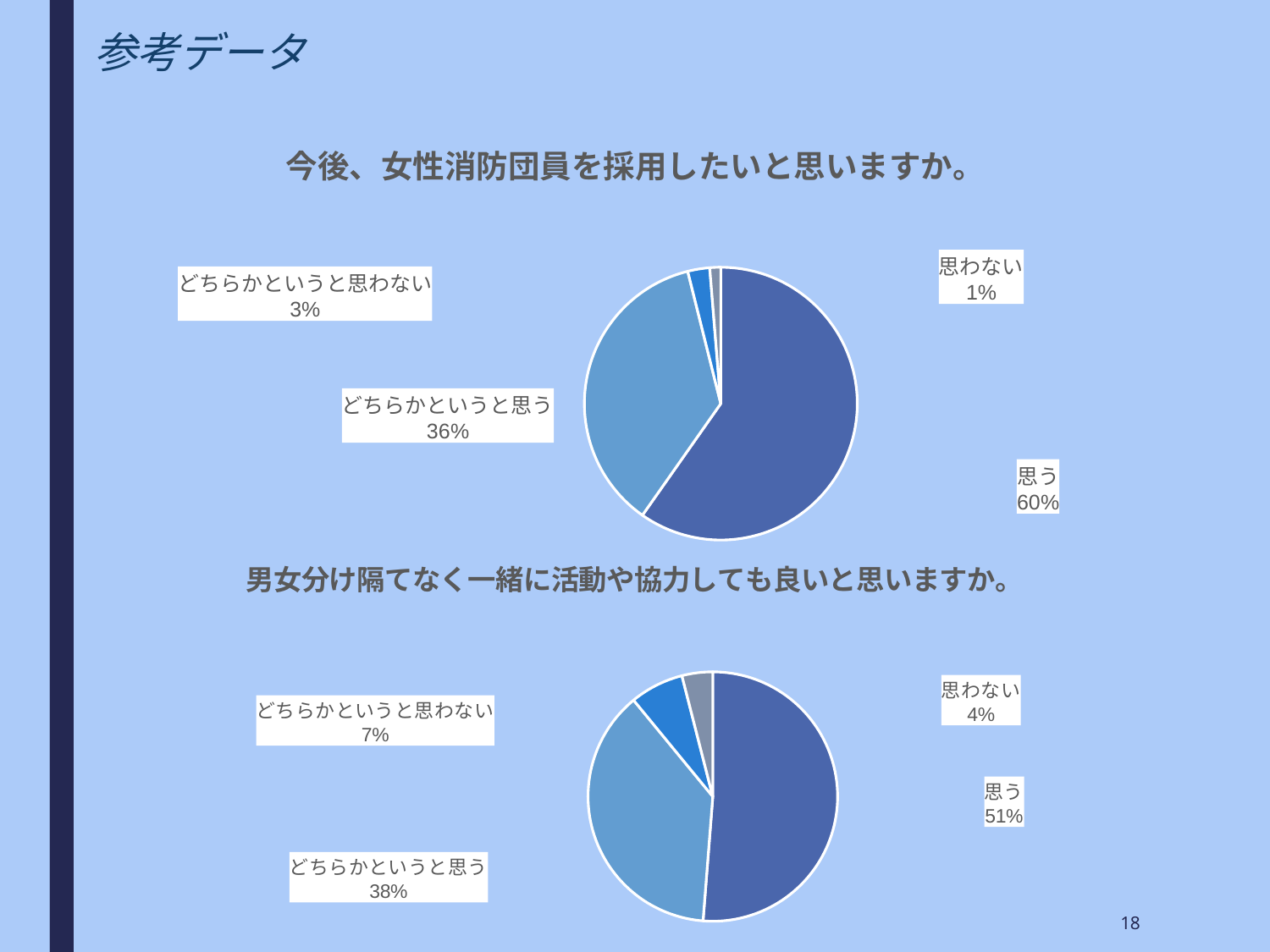
In the bottom chart (男女分け隔てなく一緒に活動や協力しても良いと思いますか。), which response has the largest share? 思う In the top chart (今後、女性消防団員を採用したいと思いますか。), how many slices does the pie have? 4 In the bottom chart (男女分け隔てなく一緒に活動や協力しても良いと思いますか。), which is larger: the share for どちらかというと思わない or the share for 思わない? どちらかというと思わない In the bottom chart (男女分け隔てなく一緒に活動や協力しても良いと思いますか。), what share of respondents answered どちらかというと思わない? 7% In the top chart (今後、女性消防団員を採用したいと思いますか。), what share of respondents answered どちらかというと思う? 36% In the top chart (今後、女性消防団員を採用したいと思いますか。), what share of respondents answered 思う? 60% In the bottom chart (男女分け隔てなく一緒に活動や協力しても良いと思いますか。), what share of respondents answered 思う? 51% In the top chart (今後、女性消防団員を採用したいと思いますか。), what is the difference between the shares for 思う and どちらかというと思う? 24% In the top chart (今後、女性消防団員を採用したいと思いますか。), which response has the smallest share? 思わない In the bottom chart (男女分け隔てなく一緒に活動や協力しても良いと思いますか。), what is the difference between the shares for 思う and どちらかというと思う? 13% How many pie charts are shown on the slide? 2 What kind of chart is the bottom chart (男女分け隔てなく一緒に活動や協力しても良いと思いますか。)? pie chart